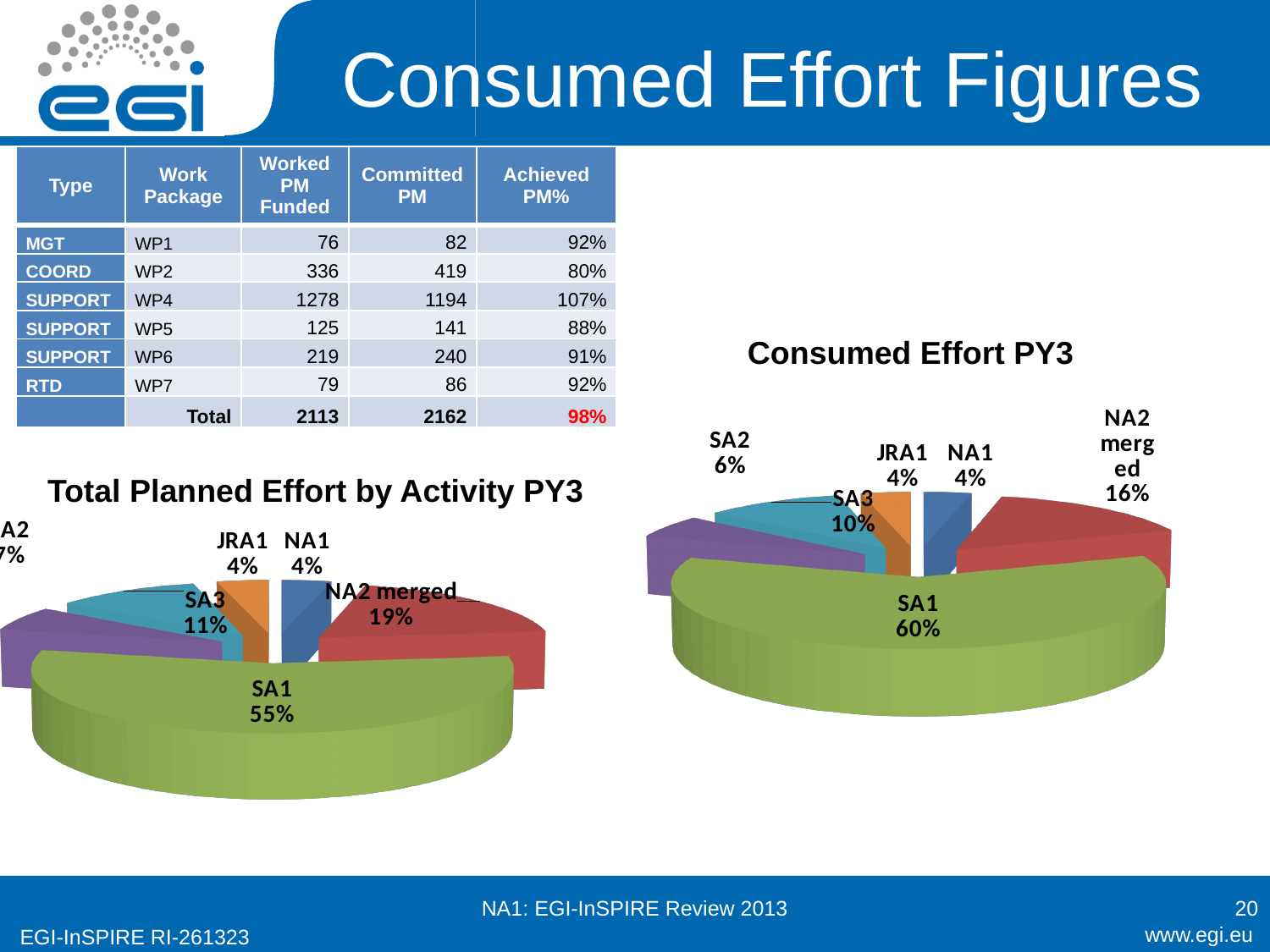
In the Consumed Effort PY3 chart, what share does SA1 have? 60% In the Consumed Effort PY3 chart, which is larger, SA3 or SA2? SA3 In the Total Planned Effort by Activity PY3 chart, what share does SA1 have? 55% In the Total Planned Effort by Activity PY3 chart, what share does NA2 merged have? 19% In the Consumed Effort PY3 chart, what share does SA2 have? 6% In the Consumed Effort PY3 chart, what share does NA2 merged have? 16% In the Total Planned Effort by Activity PY3 chart, what share does SA3 have? 11% In the Consumed Effort PY3 chart, which activity has the largest share? SA1 What kind of chart is the Consumed Effort PY3 chart? Pie chart In the Consumed Effort PY3 chart, what is the difference in percentage points between SA1 and NA2 merged? 44 In the Total Planned Effort by Activity PY3 chart, which activity has the largest share? SA1 How many slices does the Consumed Effort PY3 chart have? 6